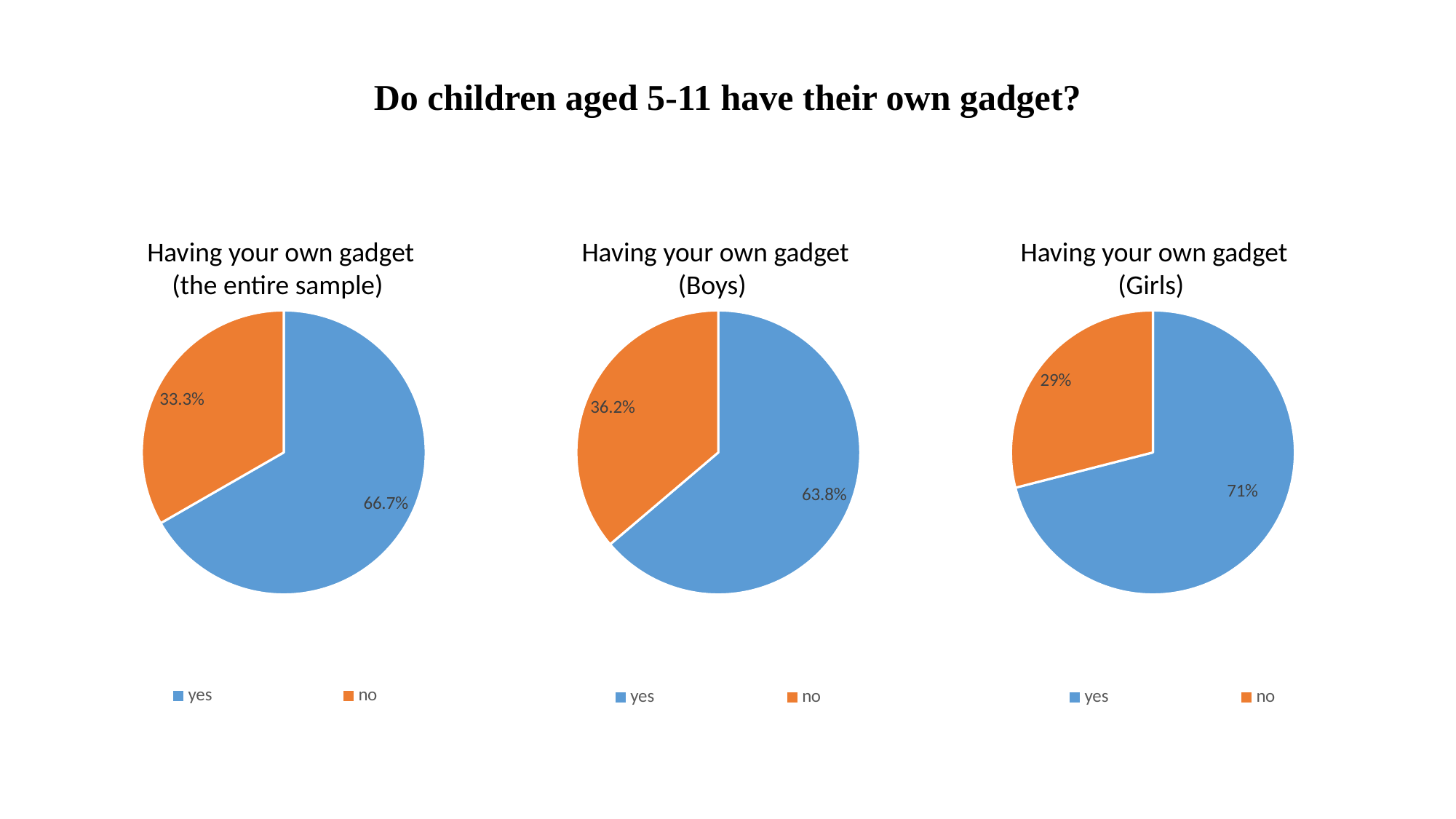
In the 'Having your own gadget (Girls)' chart, what is the value for 'yes'? 71% In the 'Having your own gadget (Girls)' chart, what is the value for 'no'? 29% How many entries does the legend of the 'Having your own gadget (Boys)' chart list? 2 What kind of chart is 'Having your own gadget (the entire sample)'? pie chart Is the 'yes' value larger in the 'Having your own gadget (Boys)' chart or in the 'Having your own gadget (Girls)' chart? Girls In the 'Having your own gadget (Boys)' chart, what is the value for 'yes'? 63.8% In the 'Having your own gadget (the entire sample)' chart, what is the value for 'no'? 33.3% In the 'Having your own gadget (Girls)' chart, what is the difference between the 'yes' and 'no' values? 42% In the 'Having your own gadget (Girls)' chart, which slice is the largest? yes In the 'Having your own gadget (Boys)' chart, what share of the pie is 'no'? 36.2% In the 'Having your own gadget (the entire sample)' chart, what share of the pie is 'yes'? 66.7% In the 'Having your own gadget (Boys)' chart, which slice is the smallest? no